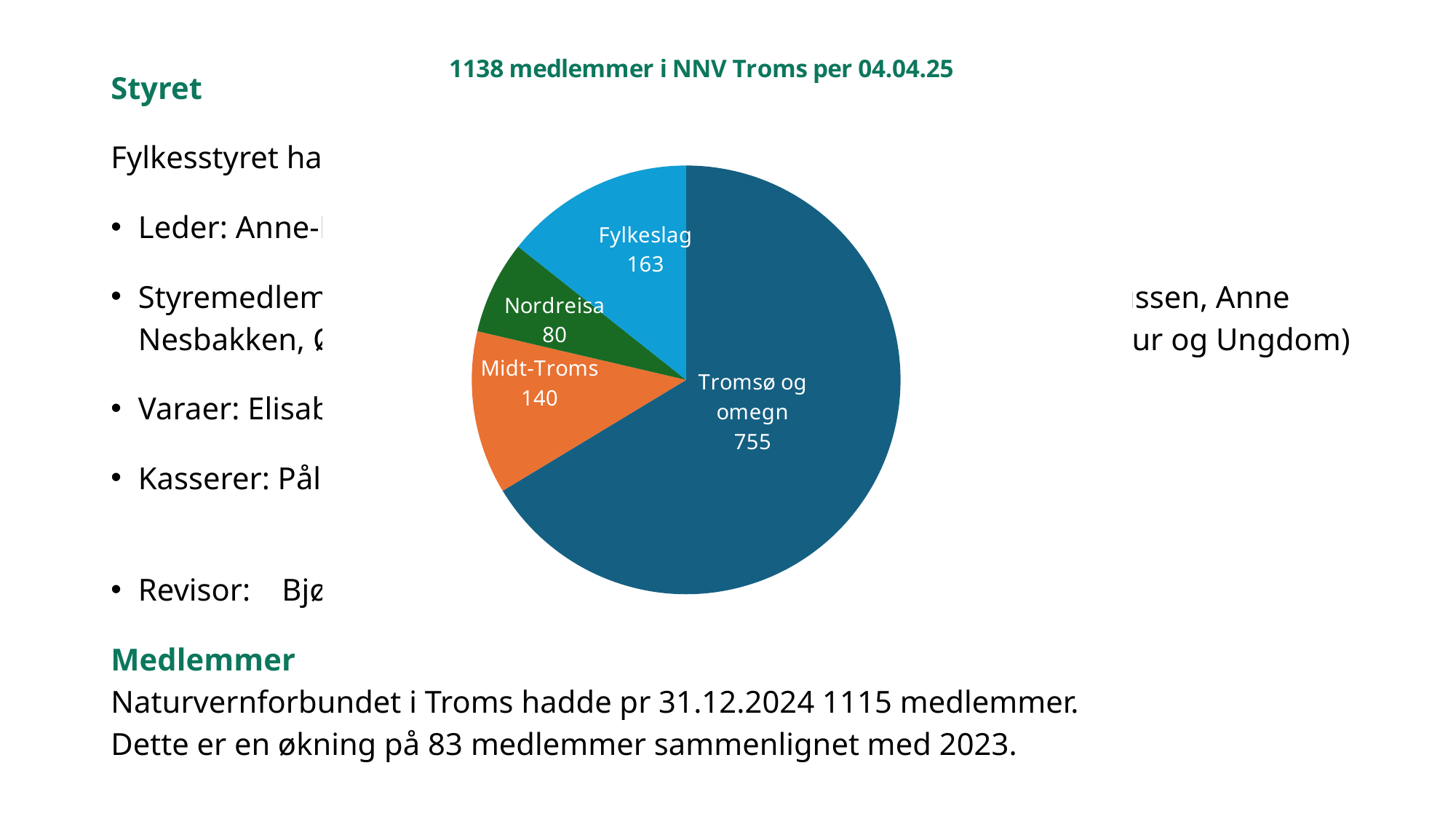
How many slices does the pie chart have? 4 Which slice of the pie chart is the largest? Tromsø og omegn How many members does the Tromsø og omegn slice show? 755 What is the total of all slices in the pie chart? 1138 What kind of chart is shown on the slide? pie chart What is the value for Nordreisa in the pie chart? 80 What is the title of the pie chart? 1138 medlemmer i NNV Troms per 04.04.25 What is the value for Fylkeslag in the pie chart? 163 What is the value for Midt-Troms in the pie chart? 140 Which slice of the pie chart is the smallest? Nordreisa What is the difference between the values for Tromsø og omegn and Midt-Troms? 615 Which is larger, Fylkeslag or Midt-Troms? Fylkeslag